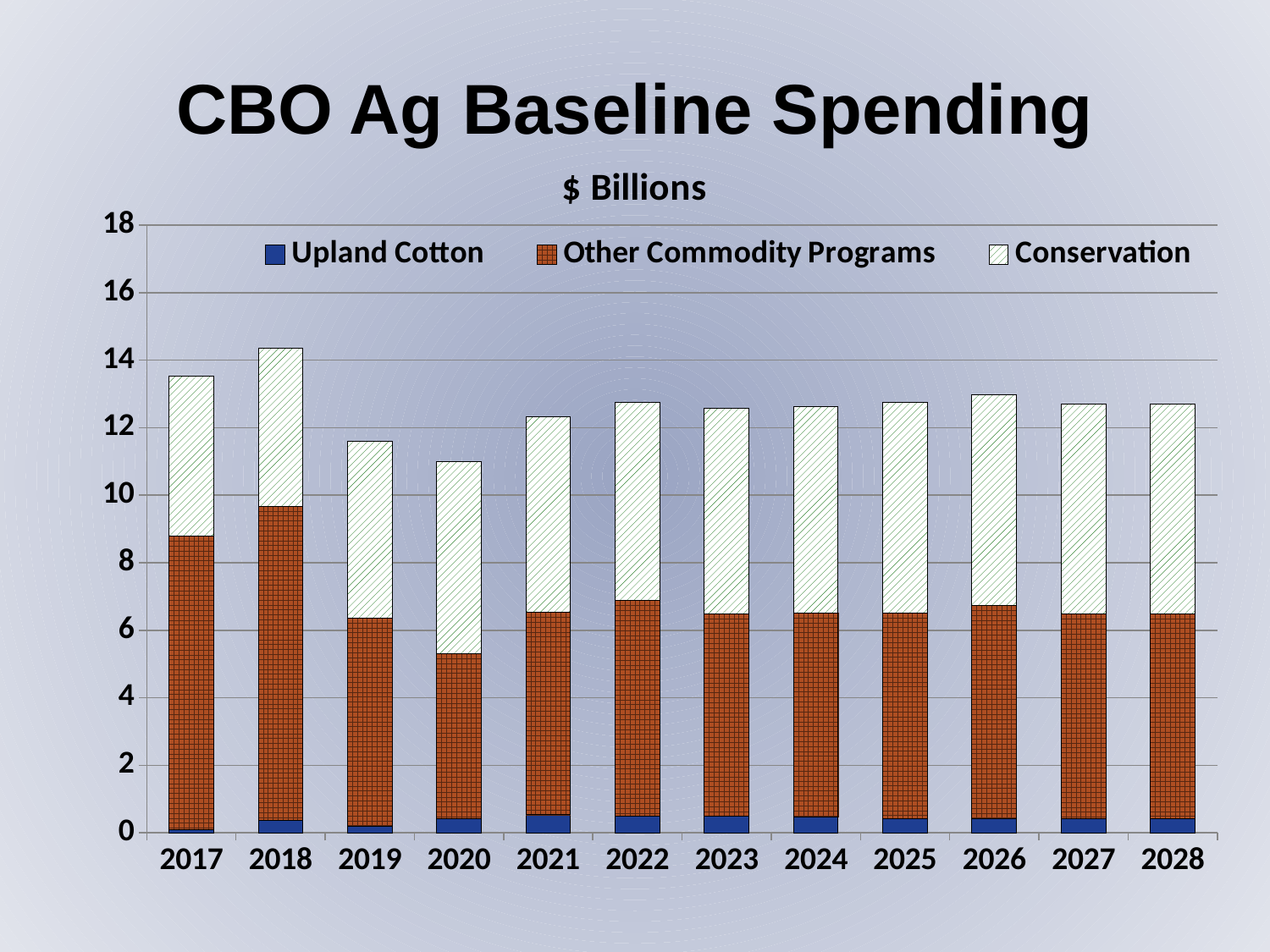
What kind of chart is shown on the slide? Stacked bar chart Is the total bar for 2018 greater or less than 14? greater Is the top of the Other Commodity Programs segment in 2017 greater or less than 8? greater How many series does the chart's legend list? 3 Which year has a larger Other Commodity Programs segment, 2017 or 2018? 2018 Do the total bars rise or fall from 2018 to 2020? fall Which year has the shortest total bar? 2020 Which year has the tallest total bar? 2018 What unit is given in the chart's subtitle? $ Billions Is the total bar for 2020 greater or less than 12? less Which year has a larger total bar, 2019 or 2020? 2019 How many years are shown on the x axis of the chart? 12